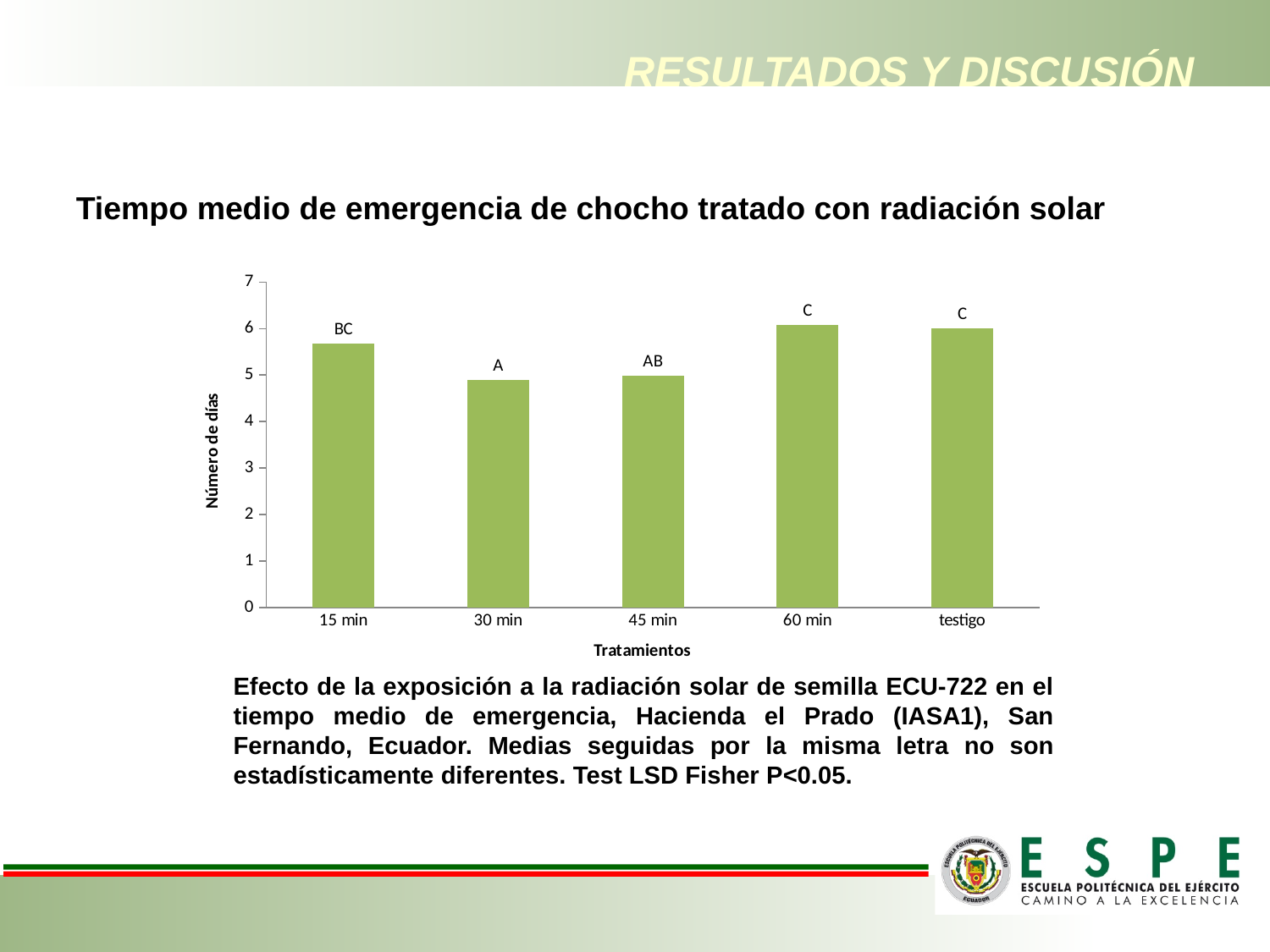
What kind of chart is shown on the slide? bar chart Is the value for 15 min greater or less than 5? greater How many treatment categories are shown on the x axis of the chart? 5 Is the value for 60 min greater or less than 5? greater Which has a higher value, 15 min or 30 min? 15 min Is the value for 45 min greater or less than 6? less Which has a higher value, 45 min or 60 min? 60 min Which has a lower value, 30 min or testigo? 30 min What is the title of the y axis of the chart? Número de días What statistical letter label is printed above the 30 min bar? A